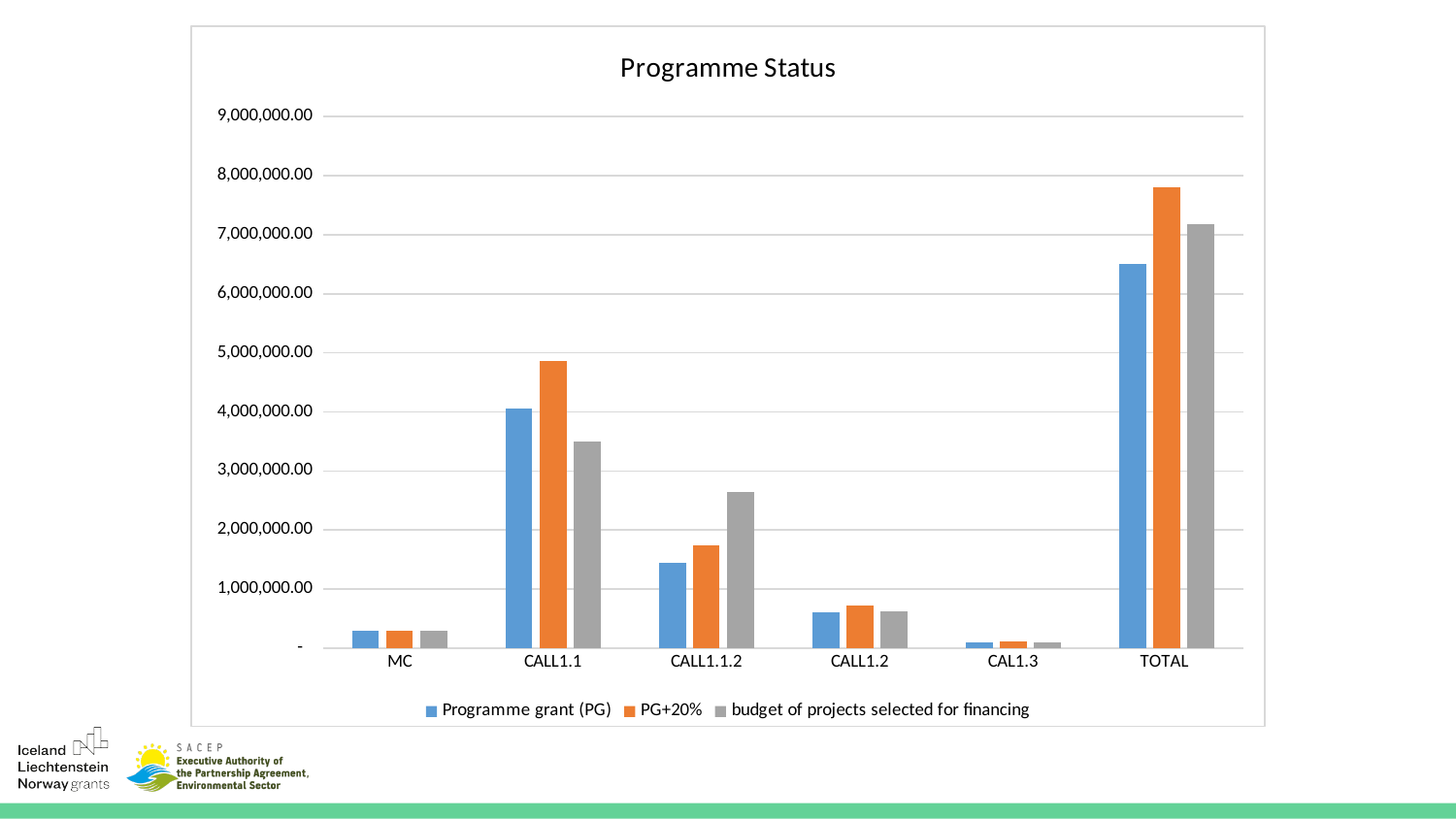
Which category has the lowest value for the Programme grant (PG) series? CAL1.3 Is the budget of projects selected for financing value for CALL1.1.2 greater or less than 2,000,000.00? greater What kind of chart is shown on the slide? bar chart Is the budget of projects selected for financing value for CALL1.1 greater or less than 4,000,000.00? less For CALL1.1.2, which is larger: the Programme grant (PG) value or the budget of projects selected for financing value? budget of projects selected for financing Which category has the highest value for the PG+20% series? TOTAL Is the PG+20% value for TOTAL greater or less than 7,000,000.00? greater What is the title of the chart? Programme Status How many categories are shown on the x axis? 6 For CALL1.1, which is larger: the PG+20% value or the budget of projects selected for financing value? PG+20% How many series does the legend list? 3